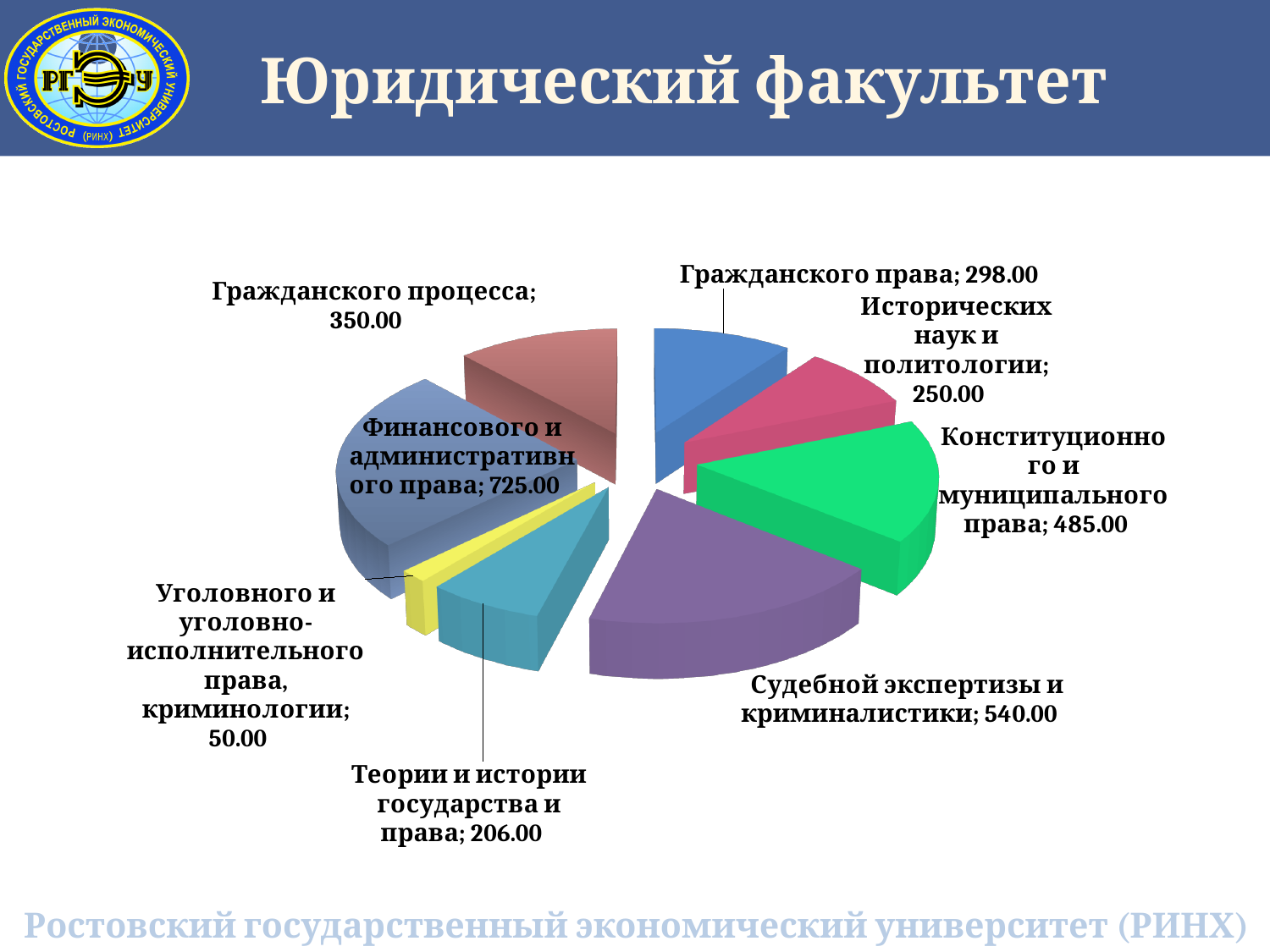
Which is larger: the value for Гражданского права or the value for Гражданского процесса? Гражданского процесса What is the title of the slide containing the pie chart? Юридический факультет What is the total of all the values shown in the pie chart? 2904.00 What is the difference between the values for Конституционного и муниципального права and Исторических наук и политологии? 235.00 How many slices does the pie chart have? 8 Which category has the largest value? Финансового и административного права What type of chart is shown on the slide? Pie chart What is the value for Финансового и административного права? 725.00 What is the value for Гражданского процесса? 350.00 What is the value for Судебной экспертизы и криминалистики? 540.00 Which category has the smallest value? Уголовного и уголовно-исполнительного права, криминологии What is the value for Теории и истории государства и права? 206.00